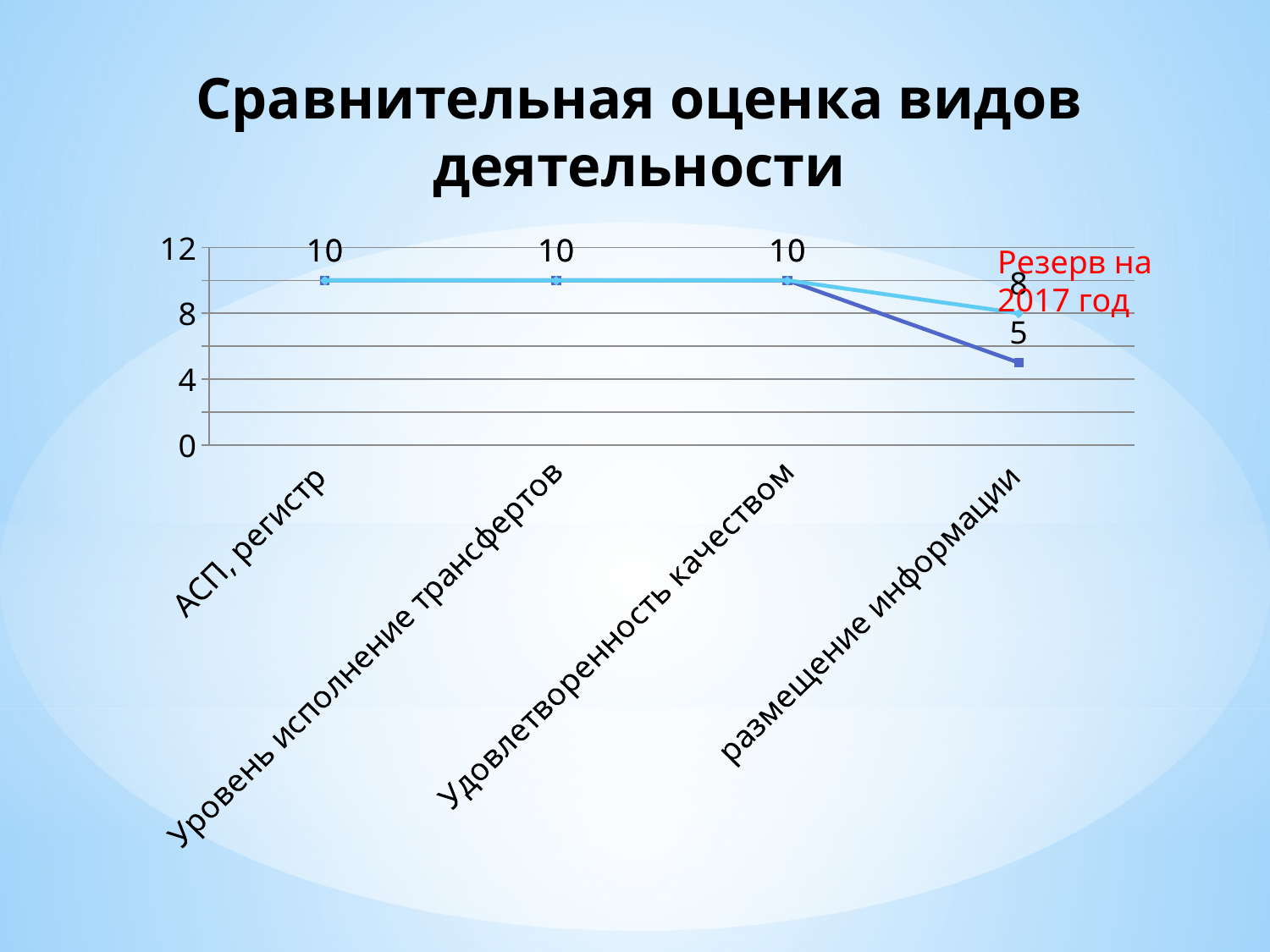
How many categories are shown on the x axis of the chart? 4 What is the value for АСП, регистр? 10 Which is larger on the dark blue line: the value for Удовлетворенность качеством or the value for размещение информации? Удовлетворенность качеством What is the title of the slide? Сравнительная оценка видов деятельности What is the value of the light blue line for размещение информации? 8 What is the value of the dark blue line for размещение информации? 5 Do the values rise or fall along the x axis from Удовлетворенность качеством to размещение информации? fall What is the value for Уровень исполнение трансфертов? 10 Is the dark blue line's value for размещение информации greater or less than 8? less Which category has the lowest value on the chart? размещение информации What kind of chart is shown on the slide? line chart What is the difference between the two lines' values for размещение информации? 3